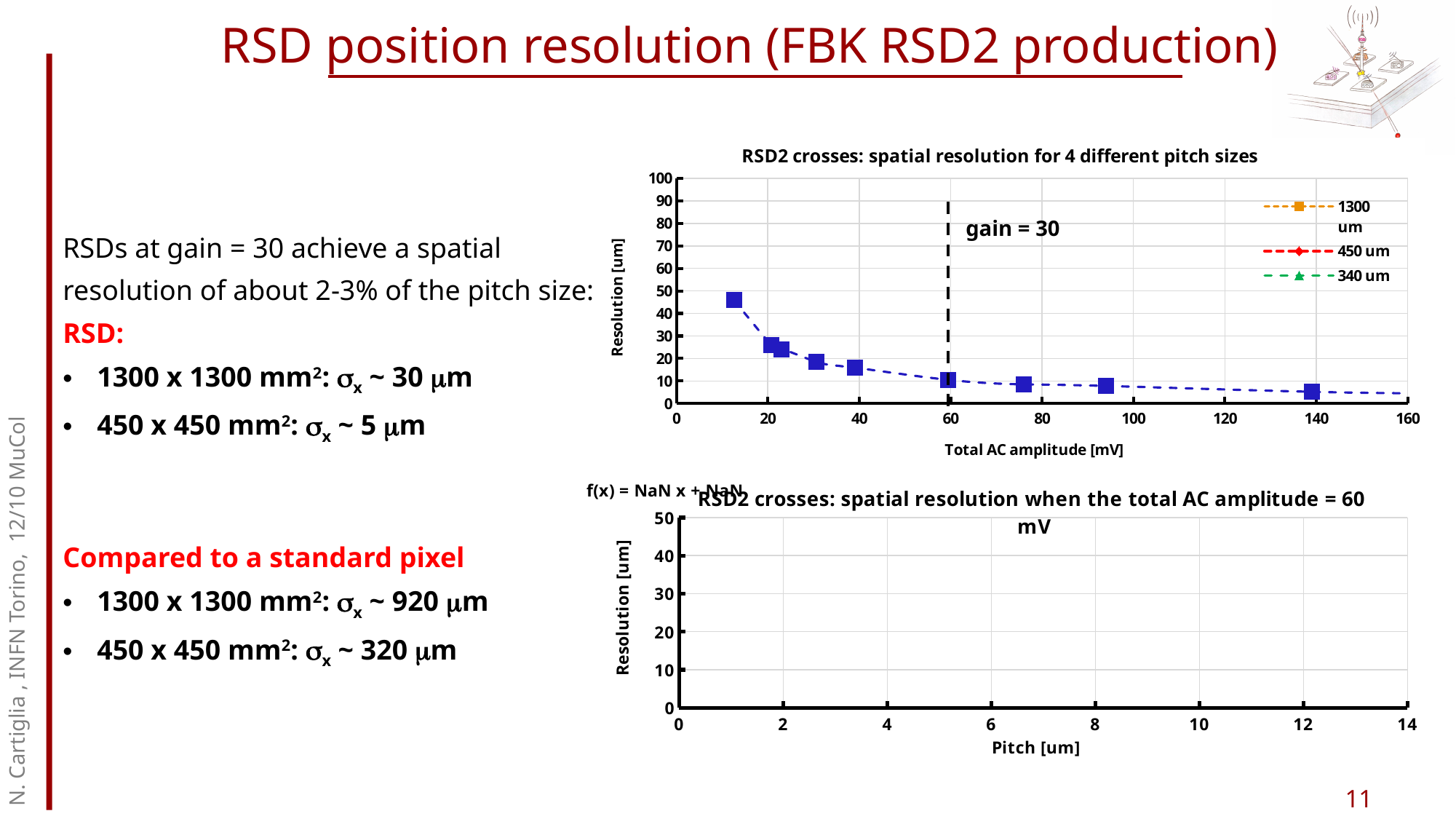
In the top chart, which data point has the highest resolution: the one near 12 mV or the one near 140 mV? The one near 12 mV In the top chart, what is the x-axis title? Total AC amplitude [mV] In the top chart, does the resolution rise or fall as the total AC amplitude increases? Fall In the top chart, how many data points are plotted? 9 In the top chart, is the resolution of the leftmost data point (near 12 mV) greater or less than 40 um? greater In the top chart, is the resolution of the data point near 40 mV greater or less than 20 um? less In the top chart, is the resolution of the rightmost data point (near 140 mV) greater or less than 10 um? less In the top chart titled 'RSD2 crosses: spatial resolution for 4 different pitch sizes', what kind of chart is it? Scatter (line) chart In the top chart, what label is attached to the vertical dashed line at 60 mV? gain = 30 In the top chart, how many series does the legend list? 3 In the bottom chart titled 'RSD2 crosses: spatial resolution when the total AC amplitude = 60 mV', how many data points are plotted? 0